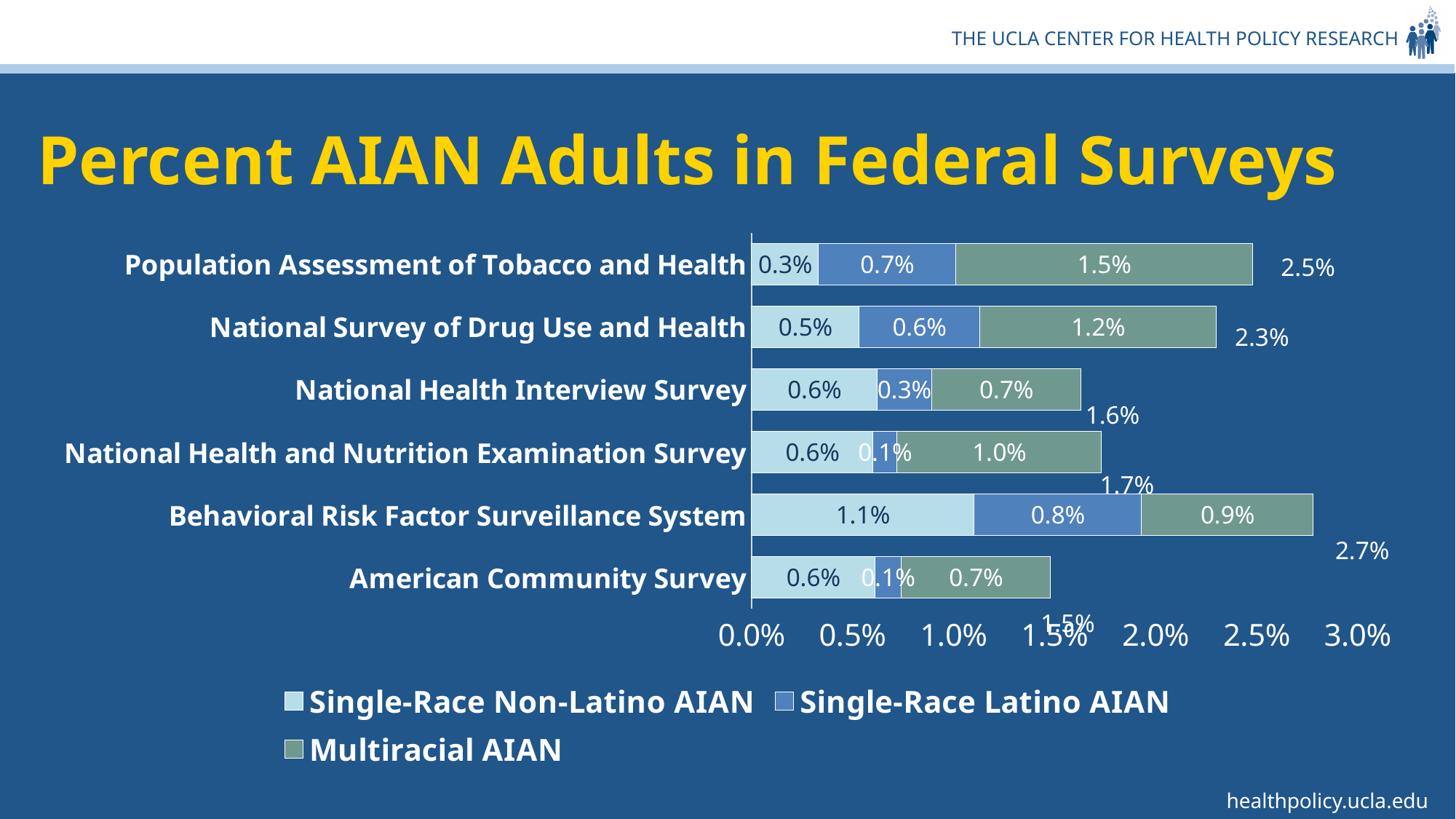
What is the Single-Race Non-Latino AIAN value for the Behavioral Risk Factor Surveillance System? 1.1% What is the difference between the Multiracial AIAN values for the Population Assessment of Tobacco and Health and the National Survey of Drug Use and Health? 0.3% What is the Multiracial AIAN value for the Population Assessment of Tobacco and Health? 1.5% What kind of chart is shown on the slide? Stacked bar chart Which is larger: the Single-Race Latino AIAN value for the Behavioral Risk Factor Surveillance System or for the National Health Interview Survey? Behavioral Risk Factor Surveillance System What is the Single-Race Latino AIAN value for the National Survey of Drug Use and Health? 0.6% What is the total percent of AIAN adults for the National Health Interview Survey? 1.6% How many series does the chart legend list? 3 What is the title of the chart on the slide? Percent AIAN Adults in Federal Surveys How many surveys are listed as categories in the chart? 6 Which survey has the lowest total percent of AIAN adults? American Community Survey Which survey has the highest total percent of AIAN adults? Behavioral Risk Factor Surveillance System